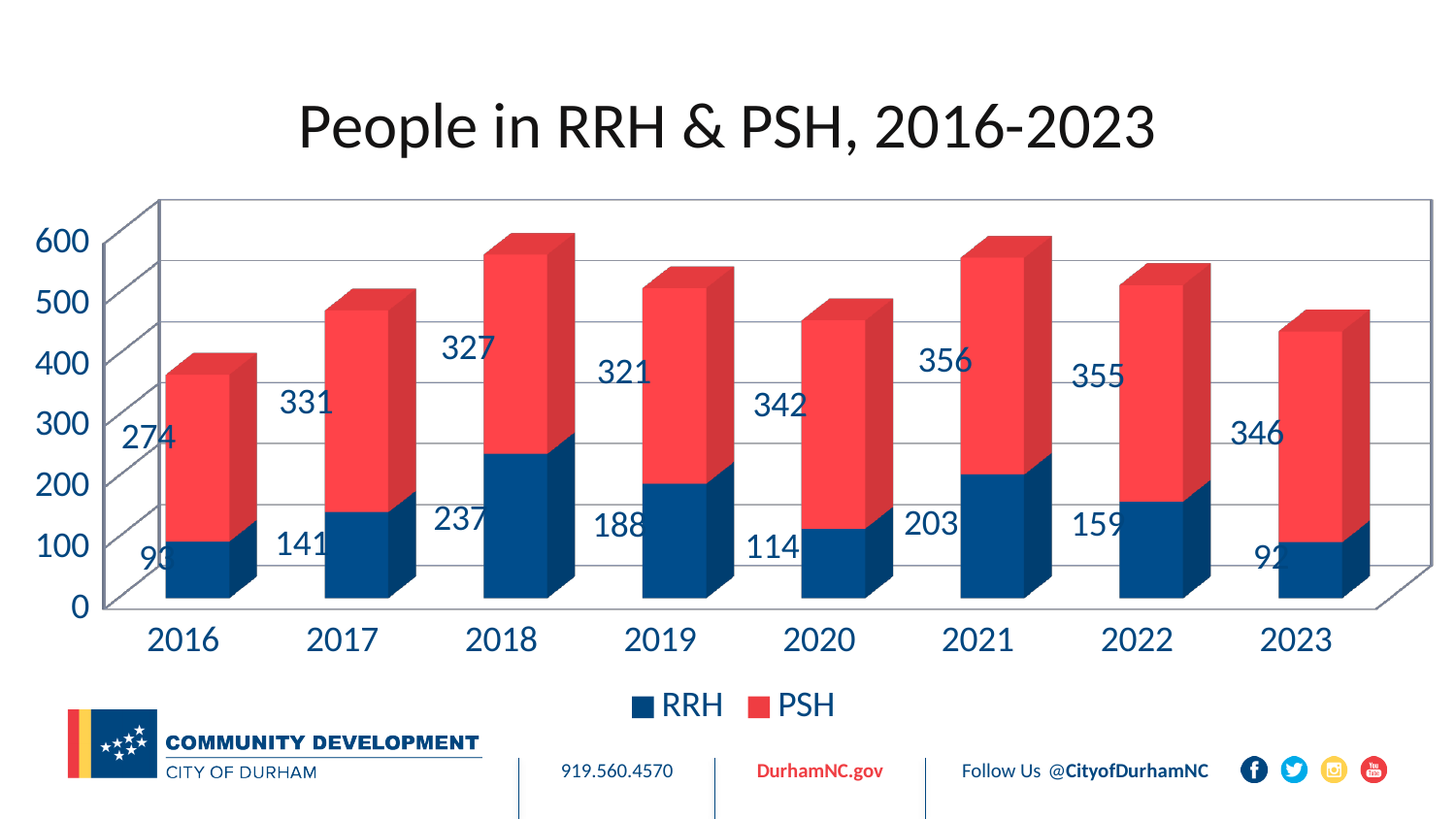
What is the PSH value for 2018? 327 What is the difference between the RRH values for 2018 and 2019? 49 What type of chart is shown on the slide? stacked bar chart How many series does the legend list? 2 What is the title of the chart? People in RRH & PSH, 2016-2023 Which year has the highest RRH value? 2018 What is the RRH value for 2021? 203 Which is larger, the RRH value for 2020 or the RRH value for 2022? 2022 What is the PSH value for 2020? 342 What is the total of the stacked bar for 2021? 559 Which year has the lowest PSH value? 2016 How many years are shown on the x axis? 8